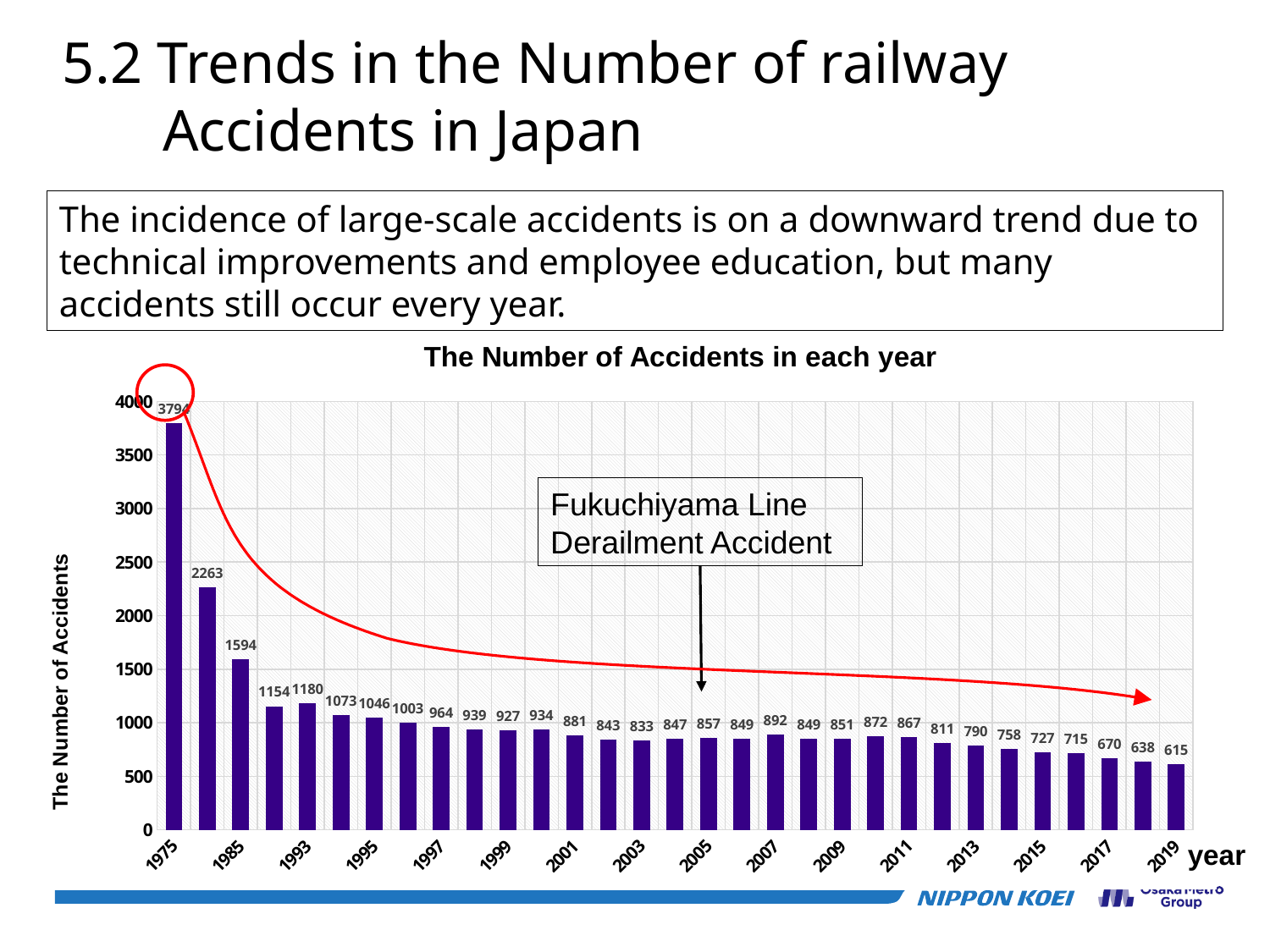
What is the number of accidents in 2005, the year of the Fukuchiyama Line Derailment Accident? 857 What is the title of the chart? The Number of Accidents in each year What is the number of accidents in 2019? 615 Which year has more accidents, 2007 or 2009? 2007 What type of chart is shown on the slide? Bar chart Overall, do the number of accidents rise or fall from 1975 to 2019? Fall What is the number of accidents in 2013? 790 Which year has the highest number of accidents? 1975 Is the number of accidents in 2011 greater or less than 1000? less What is the number of accidents in 1975? 3794 Which year has the lowest number of accidents? 2019 What is the difference between the number of accidents in 1975 and in 2019? 3179